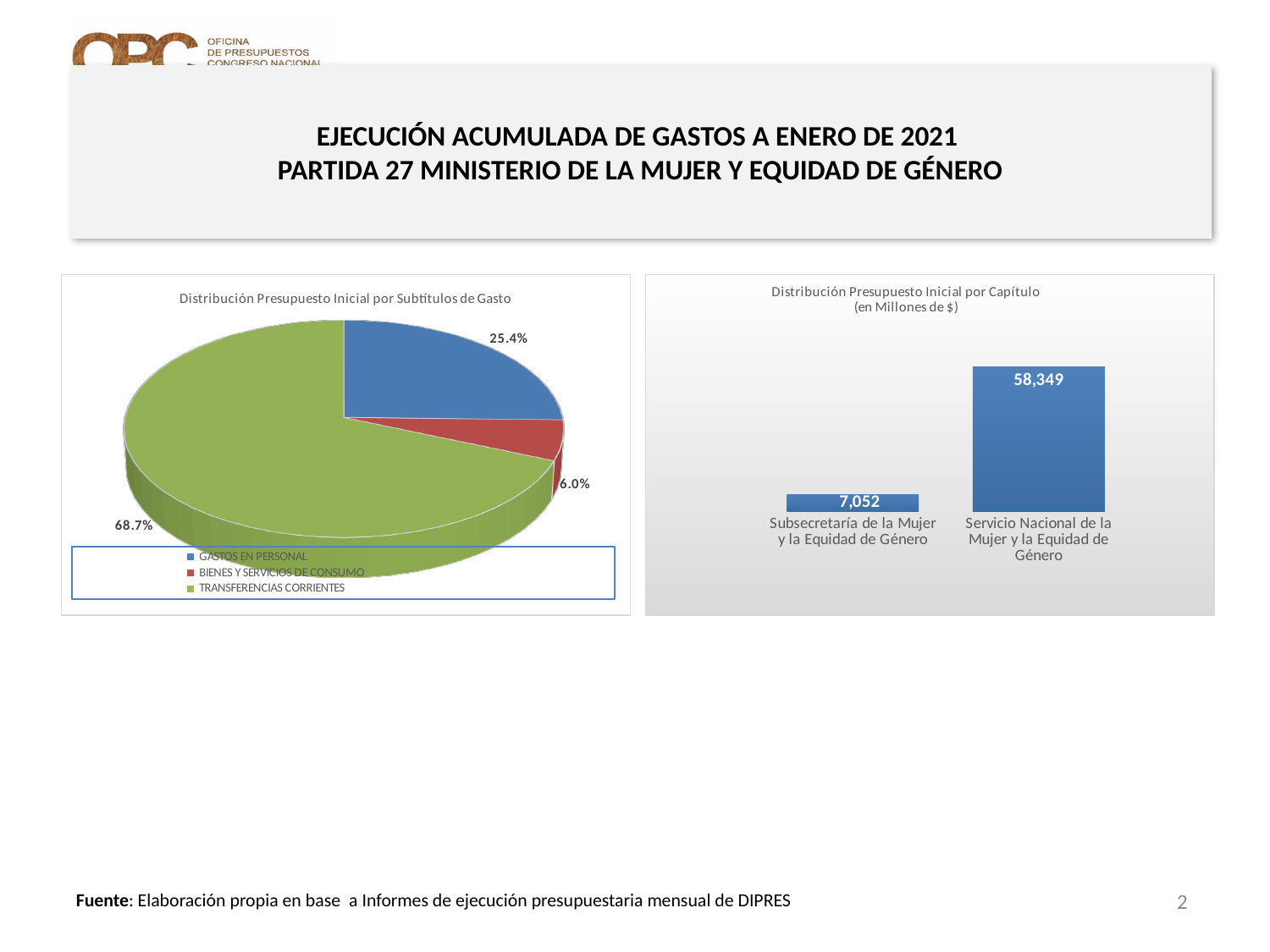
In the chart 'Distribución Presupuesto Inicial por Subtítulos de Gasto', what share does GASTOS EN PERSONAL have? 25.4% In the chart 'Distribución Presupuesto Inicial por Capítulo', what is the difference between the two values? 51,297 In the chart 'Distribución Presupuesto Inicial por Capítulo', what is the value for Subsecretaría de la Mujer y la Equidad de Género? 7,052 In the chart 'Distribución Presupuesto Inicial por Subtítulos de Gasto', what share does TRANSFERENCIAS CORRIENTES have? 68.7% How many categories does the legend of the chart 'Distribución Presupuesto Inicial por Subtítulos de Gasto' list? 3 In the chart 'Distribución Presupuesto Inicial por Subtítulos de Gasto', which category has the smallest slice? BIENES Y SERVICIOS DE CONSUMO What kind of chart is 'Distribución Presupuesto Inicial por Capítulo'? Bar chart In the chart 'Distribución Presupuesto Inicial por Capítulo', in what units are the values expressed according to the subtitle? Millones de $ In the chart 'Distribución Presupuesto Inicial por Subtítulos de Gasto', what share does BIENES Y SERVICIOS DE CONSUMO have? 6.0% What kind of chart is 'Distribución Presupuesto Inicial por Subtítulos de Gasto'? Pie chart In the chart 'Distribución Presupuesto Inicial por Subtítulos de Gasto', which category has the largest slice? TRANSFERENCIAS CORRIENTES In the chart 'Distribución Presupuesto Inicial por Capítulo', what is the value for Servicio Nacional de la Mujer y la Equidad de Género? 58,349